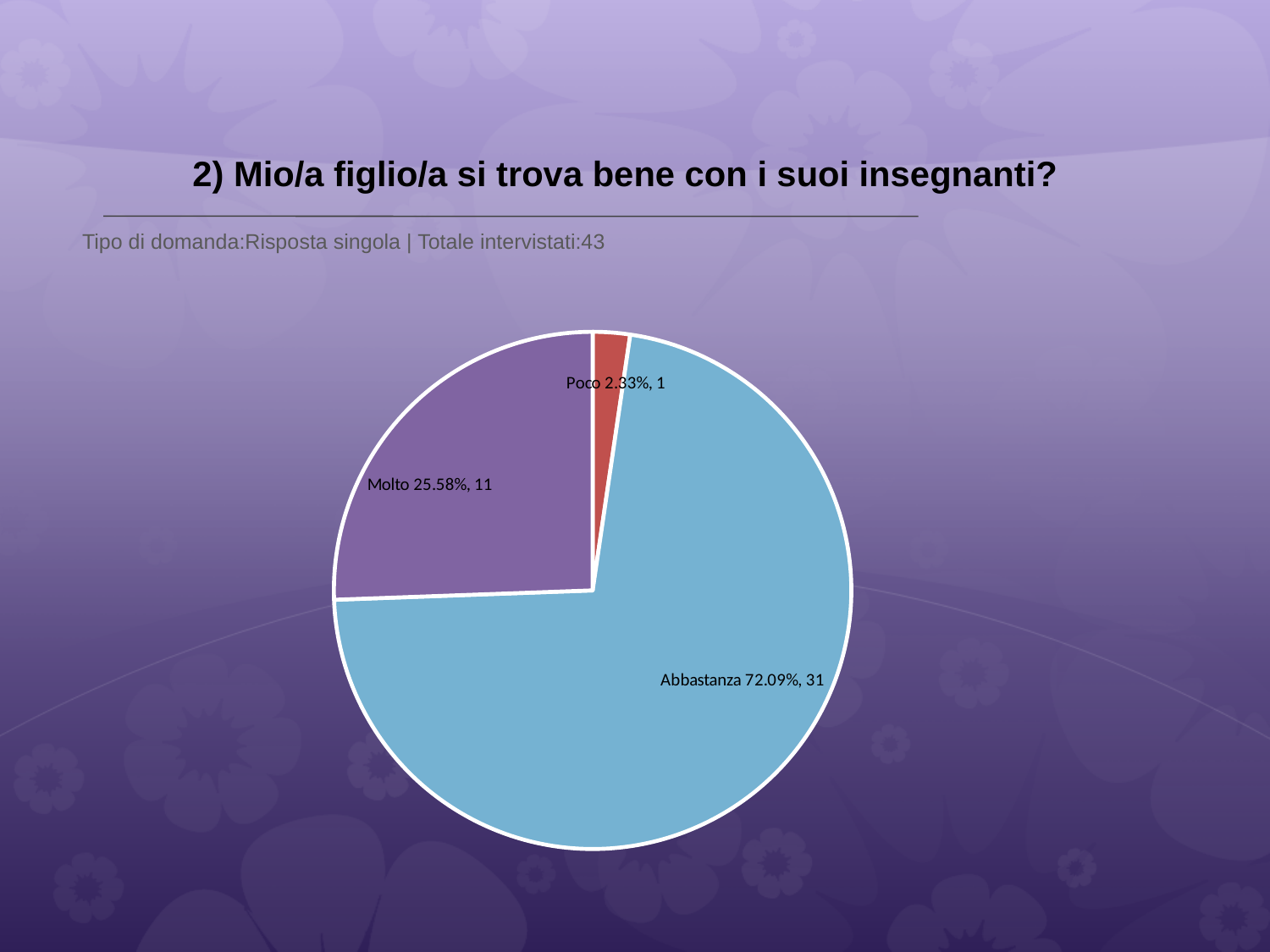
Which response has the smallest slice of the pie? Poco Which response has the largest slice of the pie? Abbastanza How many slices does the pie chart have? 3 What percentage share does the Molto slice have? 25.58% Which slice is larger, Molto or Poco? Molto How many respondents answered Abbastanza? 31 How many respondents answered Poco? 1 What percentage share does the Abbastanza slice have? 72.09% What kind of chart is shown on the slide? pie chart What percentage share does the Poco slice have? 2.33% How many more respondents answered Abbastanza than Molto? 20 How many respondents answered Molto? 11